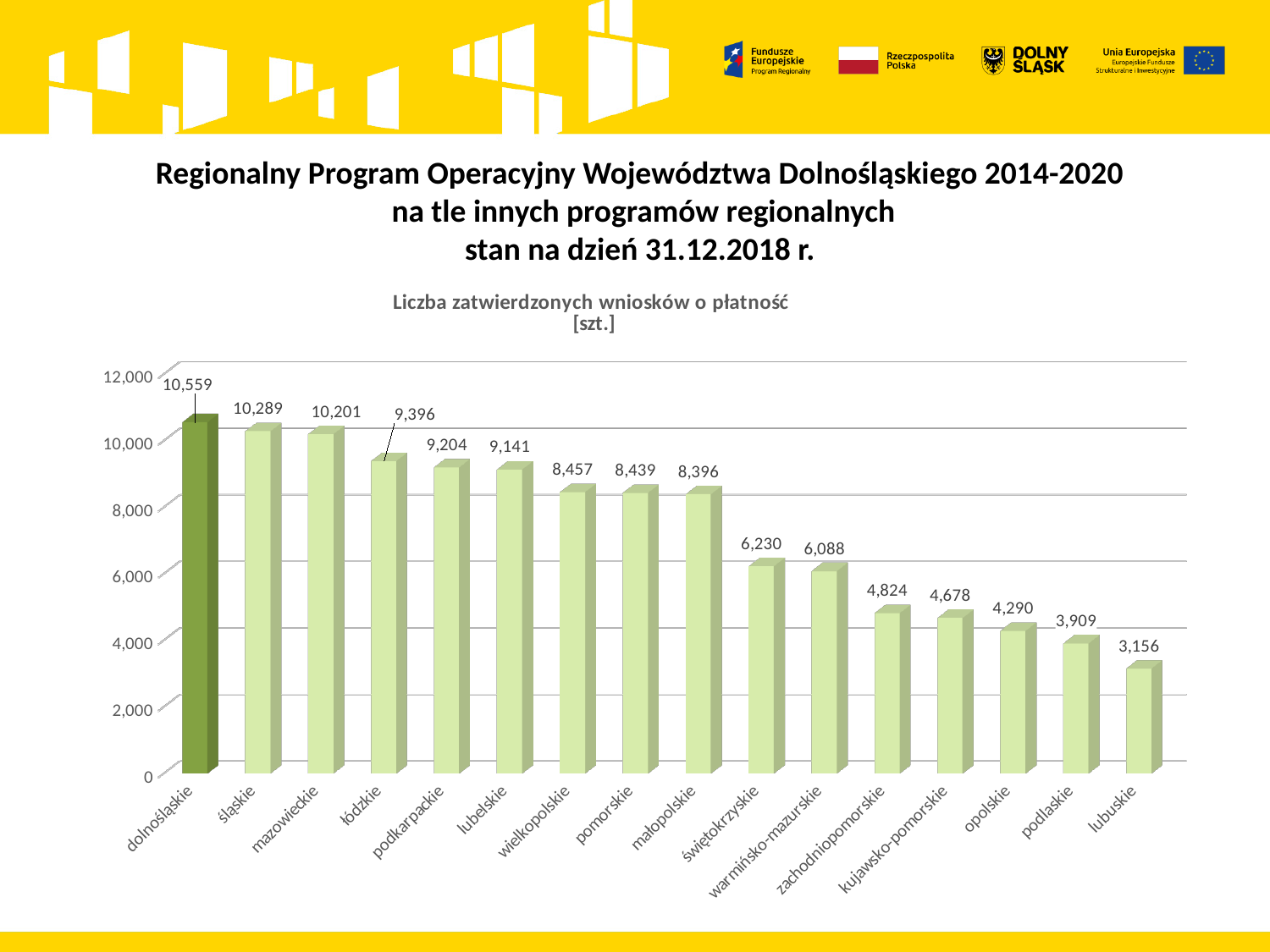
What is the difference between the values for dolnośląskie and lubuskie? 7,403 Which category has the highest value? dolnośląskie What is the value for opolskie? 4,290 What kind of chart is shown on the slide? bar chart Is the value for zachodniopomorskie greater or less than 6,000? less Which is larger, the value for pomorskie or the value for warmińsko-mazurskie? pomorskie What is the difference between the values for dolnośląskie and śląskie? 270 What is the value for świętokrzyskie? 6,230 What is the value for dolnośląskie? 10,559 Do the values rise or fall from left to right along the x axis? fall How many categories are shown on the x axis? 16 Which category has the lowest value? lubuskie